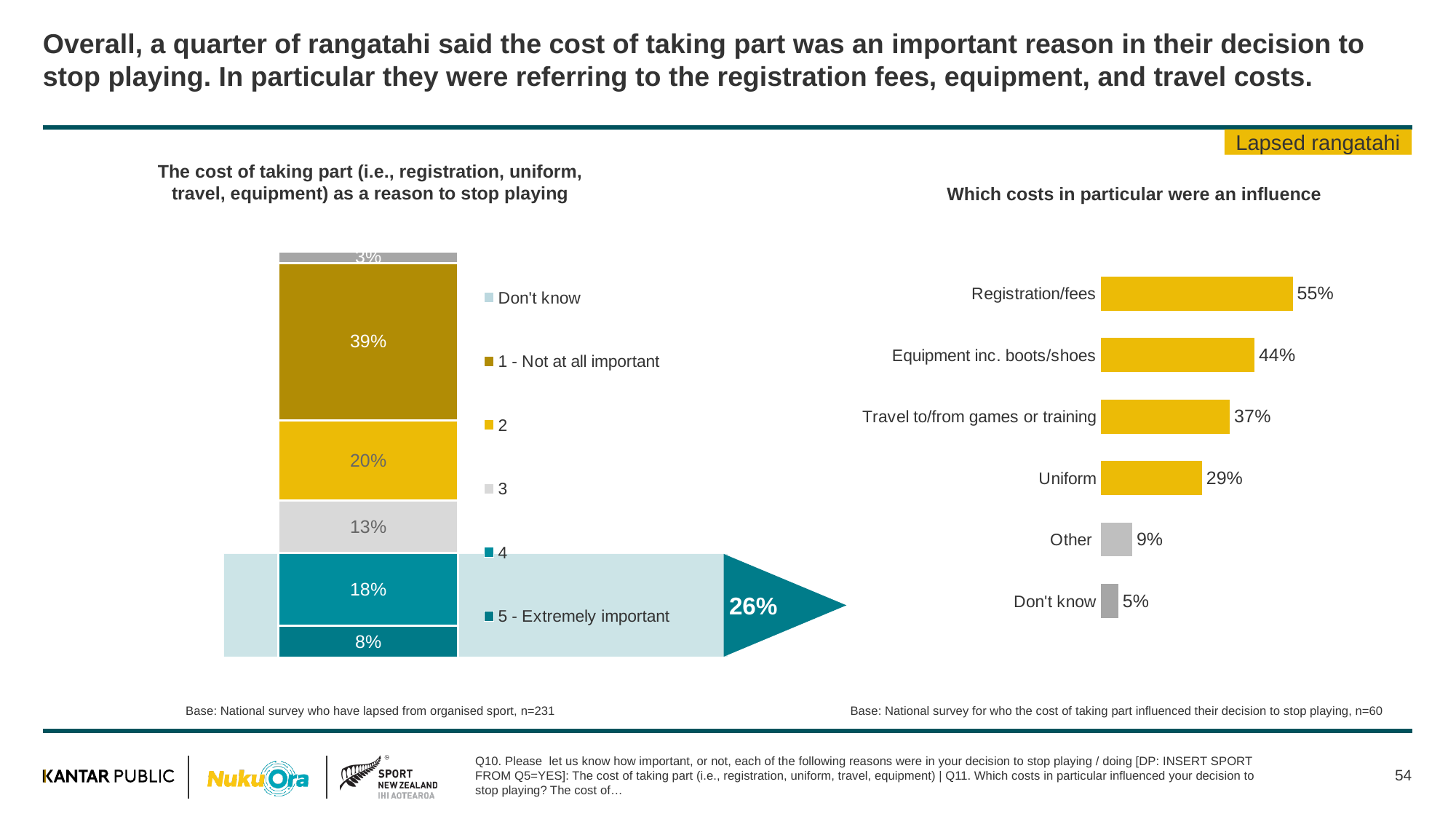
In the stacked bar chart on the left, what is the value for '1 - Not at all important'? 39% In the chart 'Which costs in particular were an influence', which is larger: Travel to/from games or training or Uniform? Travel to/from games or training How many entries does the legend of the stacked bar chart on the left list? 6 How many categories are shown in the chart 'Which costs in particular were an influence'? 6 In the stacked bar chart on the left, what is the combined value of the segments for 4 and '5 - Extremely important'? 26% In the chart 'Which costs in particular were an influence', what is the difference between Registration/fees and Equipment inc. boots/shoes? 11% What kind of chart is 'Which costs in particular were an influence'? Bar chart In the stacked bar chart on the left, what is the value for '5 - Extremely important'? 8% In the chart 'Which costs in particular were an influence', which category has the highest value? Registration/fees In the chart 'Which costs in particular were an influence', what is the value for Registration/fees? 55% In the chart 'Which costs in particular were an influence', which category has the lowest value? Don't know In the chart 'Which costs in particular were an influence', what is the value for Uniform? 29%